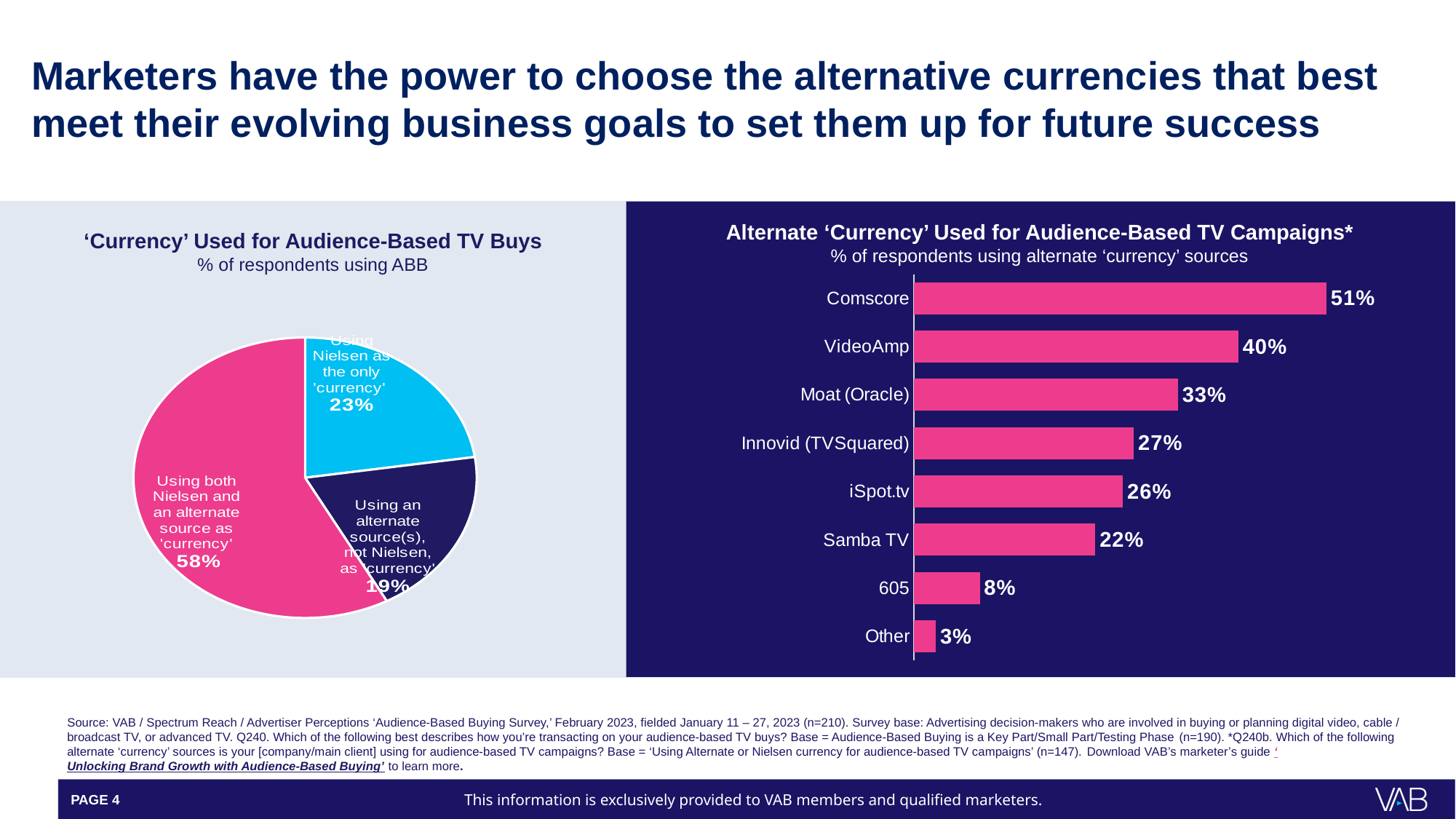
In the 'Alternate 'Currency' Used for Audience-Based TV Campaigns' chart, which source has the highest value? Comscore In the 'Alternate 'Currency' Used for Audience-Based TV Campaigns' chart, what percentage of respondents use Comscore? 51% In the 'Alternate 'Currency' Used for Audience-Based TV Campaigns' chart, what is the difference between VideoAmp and Moat (Oracle)? 7% How many slices does the ''Currency' Used for Audience-Based TV Buys' pie chart have? 3 In the ''Currency' Used for Audience-Based TV Buys' pie chart, what share of respondents are using Nielsen as the only 'currency'? 23% In the 'Alternate 'Currency' Used for Audience-Based TV Campaigns' chart, which is larger, iSpot.tv or 605? iSpot.tv What is the subtitle of the ''Currency' Used for Audience-Based TV Buys' chart? % of respondents using ABB In the 'Alternate 'Currency' Used for Audience-Based TV Campaigns' chart, which source has the lowest value? Other In the ''Currency' Used for Audience-Based TV Buys' pie chart, which slice is the largest? Using both Nielsen and an alternate source as 'currency' How many sources are listed in the 'Alternate 'Currency' Used for Audience-Based TV Campaigns' chart? 8 What kind of chart is the 'Alternate 'Currency' Used for Audience-Based TV Campaigns' chart? Bar chart In the 'Alternate 'Currency' Used for Audience-Based TV Campaigns' chart, what is the value for Samba TV? 22%